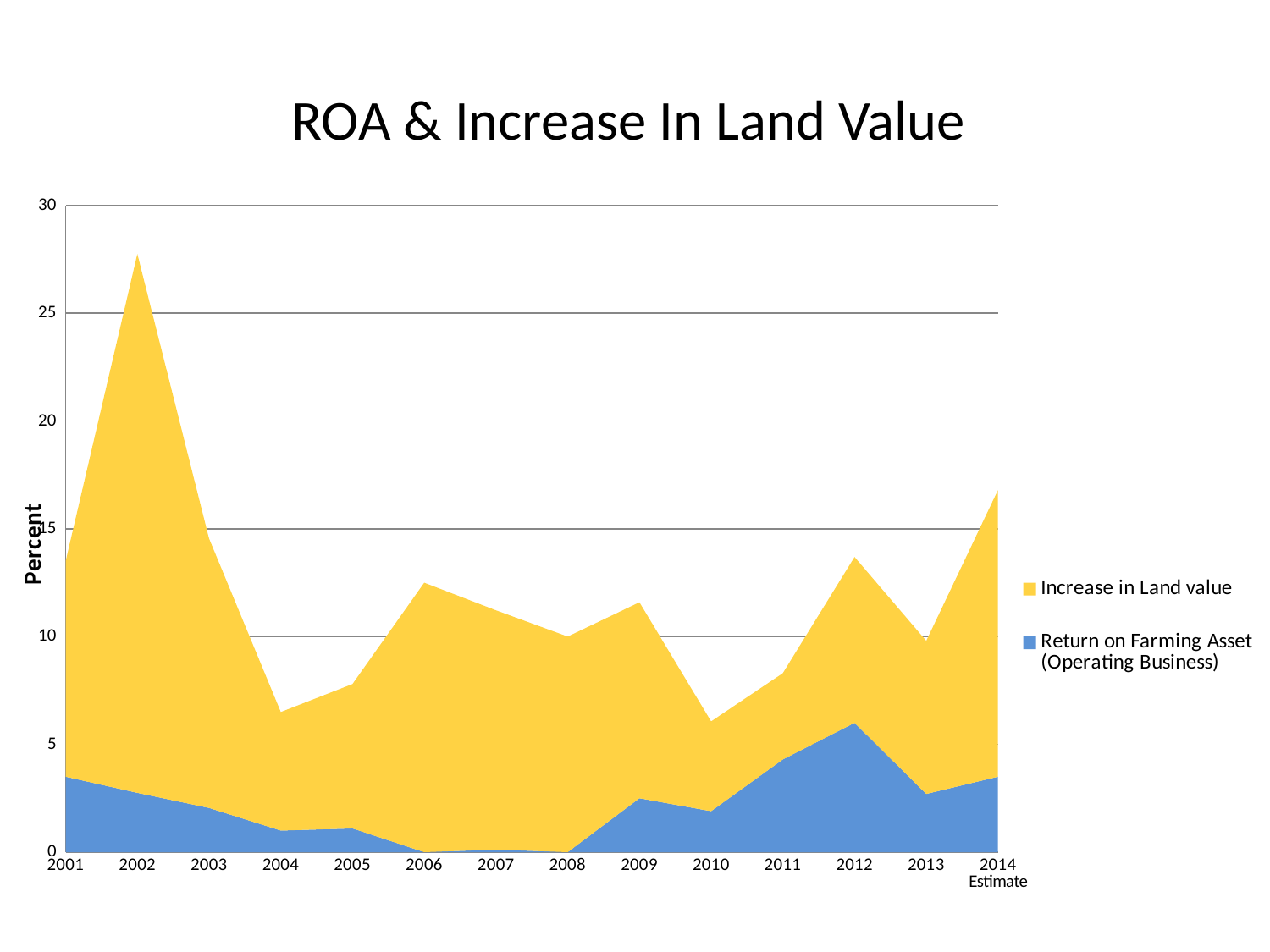
Is the Return on Farming Asset (Operating Business) value for 2001 greater or less than 5? less Is the combined total for 2014 Estimate greater or less than 15? greater What kind of chart is shown on the slide? Stacked area chart In which year is the Return on Farming Asset (Operating Business) value highest? 2012 Does the Return on Farming Asset (Operating Business) value rise or fall from 2008 to 2012? rise What is the title of the chart? ROA & Increase In Land Value Which year has the larger combined total, 2002 or 2014 Estimate? 2002 How many series does the legend list? 2 Is the combined total for 2002 greater or less than 25? greater How many years are shown along the x axis? 14 In which year does the combined total of the two series reach its highest point? 2002